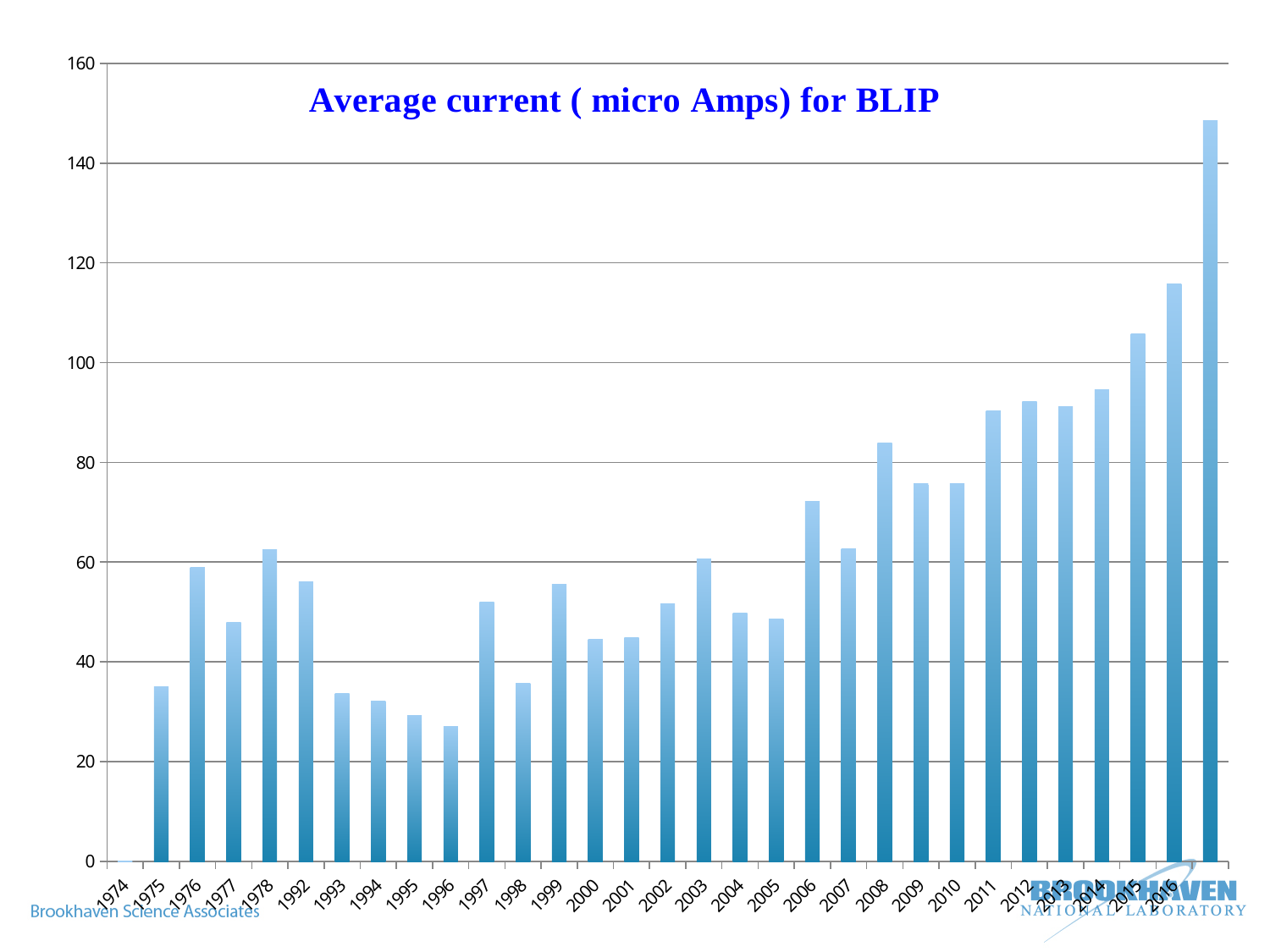
Is the value for 1996 greater or less than 40? less Which year has the lowest average current? 1974 Which is larger, the value for 1976 or the value for 1977? 1976 What is the title of the chart? Average current ( micro Amps) for BLIP Which is larger, the value for 2016 or the value for 2015? 2016 Is the value for 2015 greater or less than 100? greater Do the values rise or fall from 1992 to 1996? fall Is the value for 2016 greater or less than 120? less What kind of chart is shown on the slide? bar chart Which is larger, the value for 2006 or the value for 2007? 2006